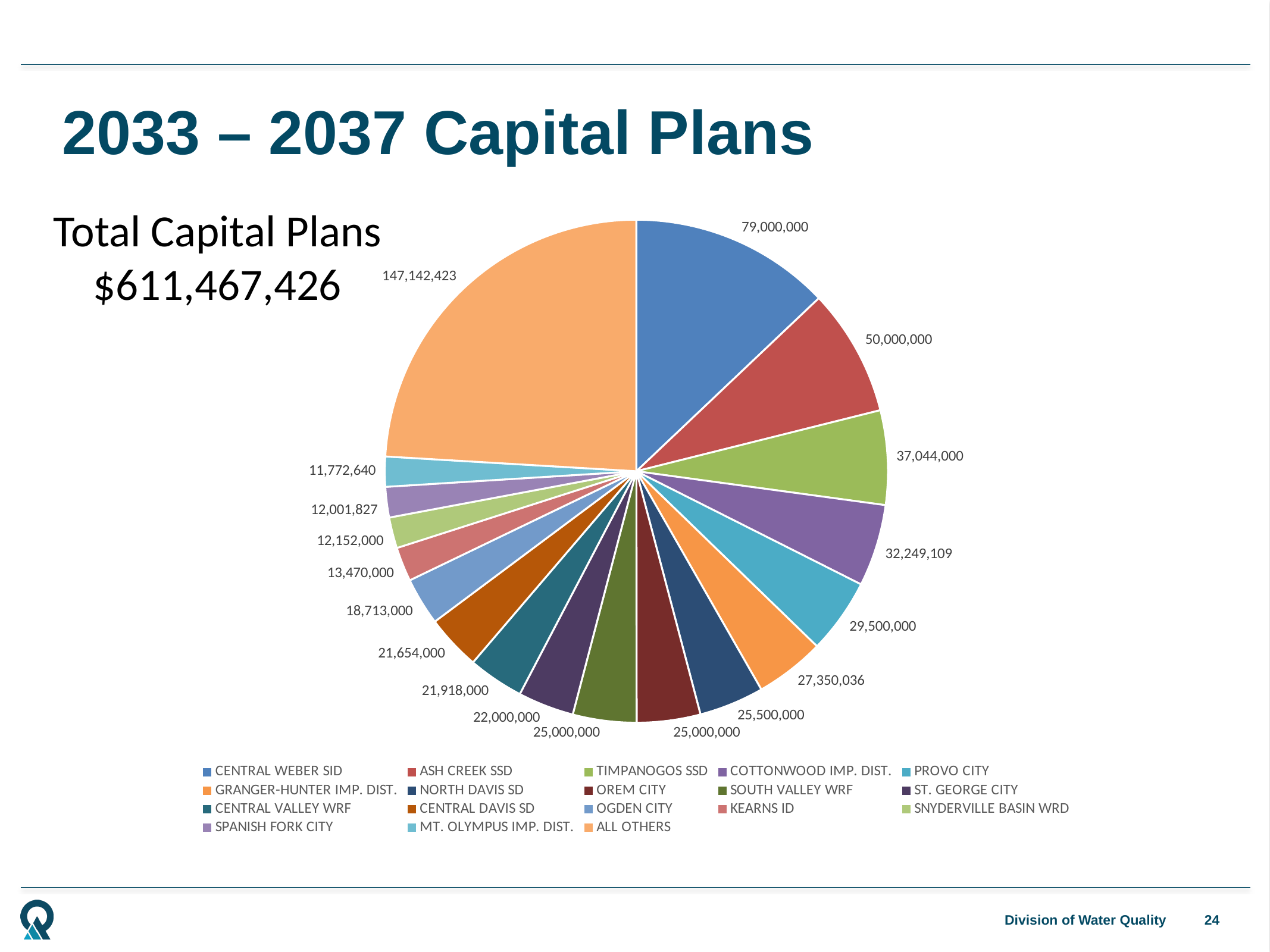
How many slices does the pie chart have? 18 What is the value for MT. OLYMPUS IMP. DIST.? 11,772,640 Which slice of the pie is the smallest? MT. OLYMPUS IMP. DIST. Which slice of the pie is the largest? ALL OTHERS What is the title of the slide containing the pie chart? 2033 – 2037 Capital Plans What is the value for ASH CREEK SSD? 50,000,000 What is the total of all capital plans shown on the slide? $611,467,426 What is the value for CENTRAL WEBER SID? 79,000,000 What is the value for COTTONWOOD IMP. DIST.? 32,249,109 What is the difference between the values for CENTRAL WEBER SID and ASH CREEK SSD? 29,000,000 Which is larger, the value for TIMPANOGOS SSD or the value for PROVO CITY? TIMPANOGOS SSD What type of chart is shown on the slide? pie chart